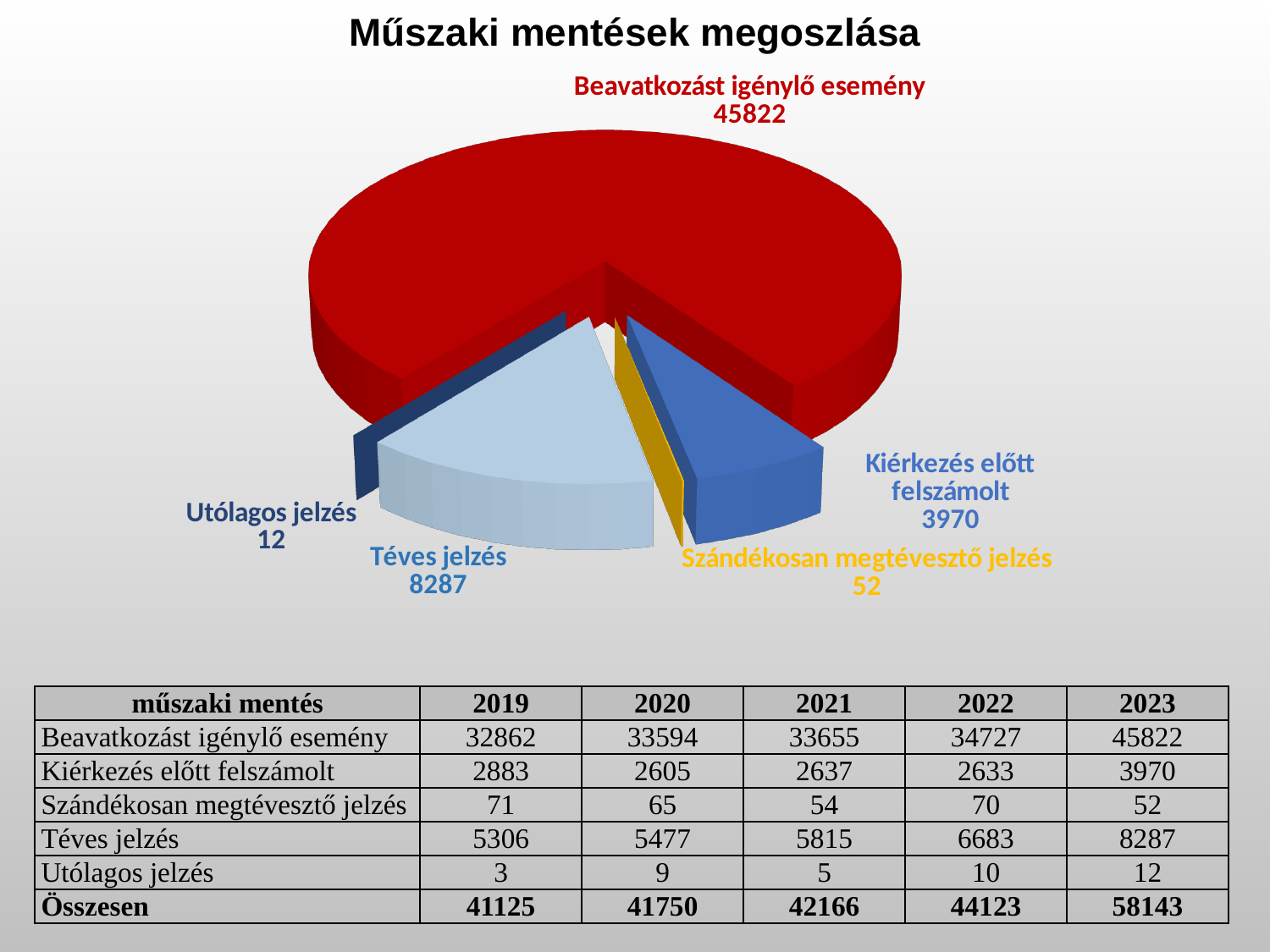
What is the title of the chart? Műszaki mentések megoszlása What is the value for Téves jelzés in the pie chart? 8287 Which category has the largest slice in the pie chart? Beavatkozást igénylő esemény Which is larger in the pie chart, Téves jelzés or Kiérkezés előtt felszámolt? Téves jelzés What is the difference between the values for Téves jelzés and Kiérkezés előtt felszámolt in the pie chart? 4317 How many slices does the pie chart have? 5 What is the value for Szándékosan megtévesztő jelzés in the pie chart? 52 Which category has the smallest slice in the pie chart? Utólagos jelzés What is the value for Kiérkezés előtt felszámolt in the pie chart? 3970 What is the value for Utólagos jelzés in the pie chart? 12 What is the value for Beavatkozást igénylő esemény in the pie chart? 45822 What type of chart is shown on the slide? pie chart